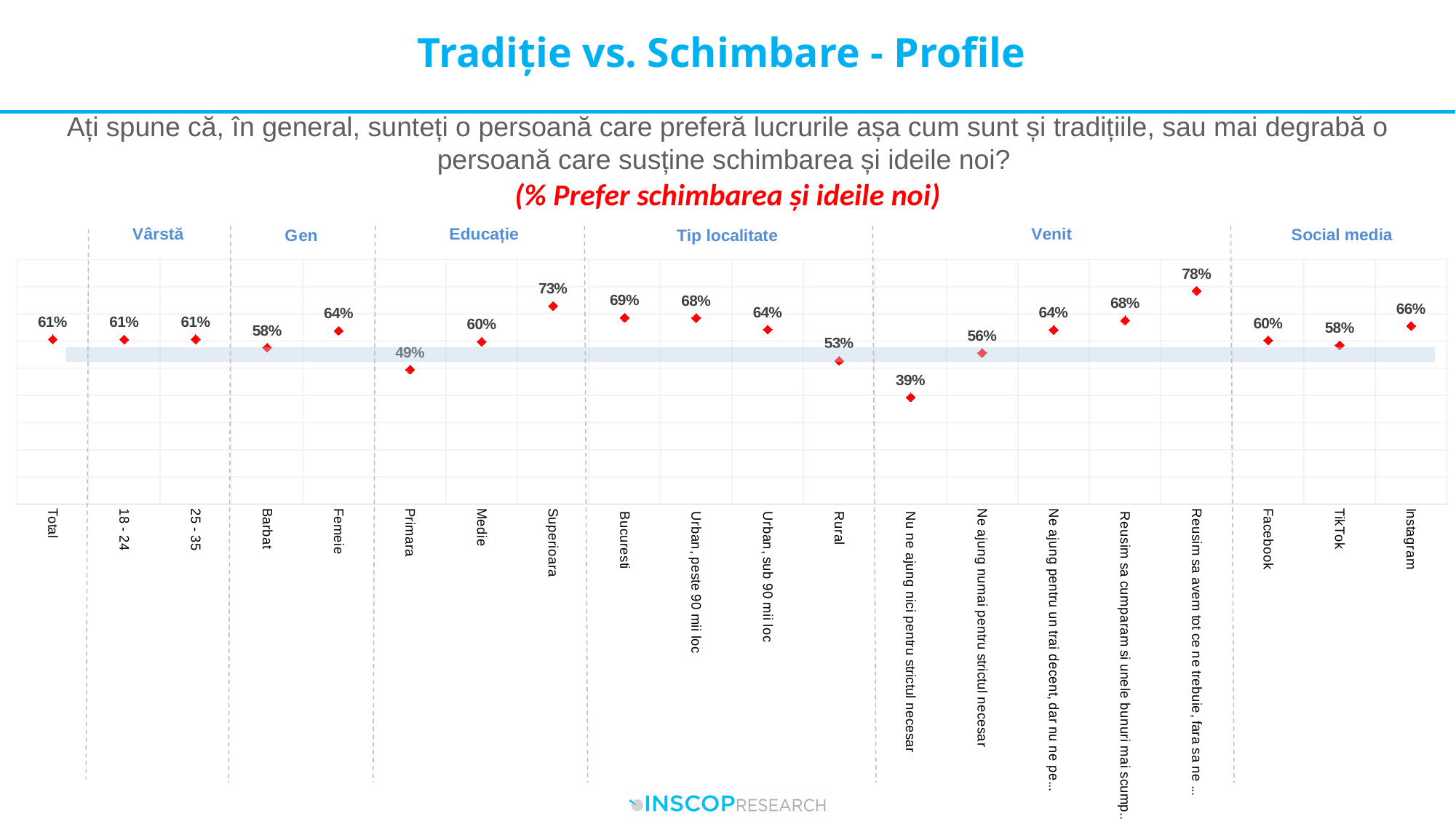
What is the value for Instagram? 66% Which has a higher value, Primara or Medie? Medie Which category has the highest value on the chart? Reusim sa avem tot ce ne trebuie, fara sa ne ... What is the value for Rural? 53% How many data points are plotted on the chart? 20 Which has a higher value, Facebook or TikTok? Facebook What is the value for Superioara? 73% What is the difference between the values for Femeie and Barbat? 6% What kind of chart is shown on the slide? Dot (scatter) chart Which category has the lowest value on the chart? Nu ne ajung nici pentru strictul necesar What is the difference between the values for Bucuresti and Rural? 16% What is the value for Total? 61%